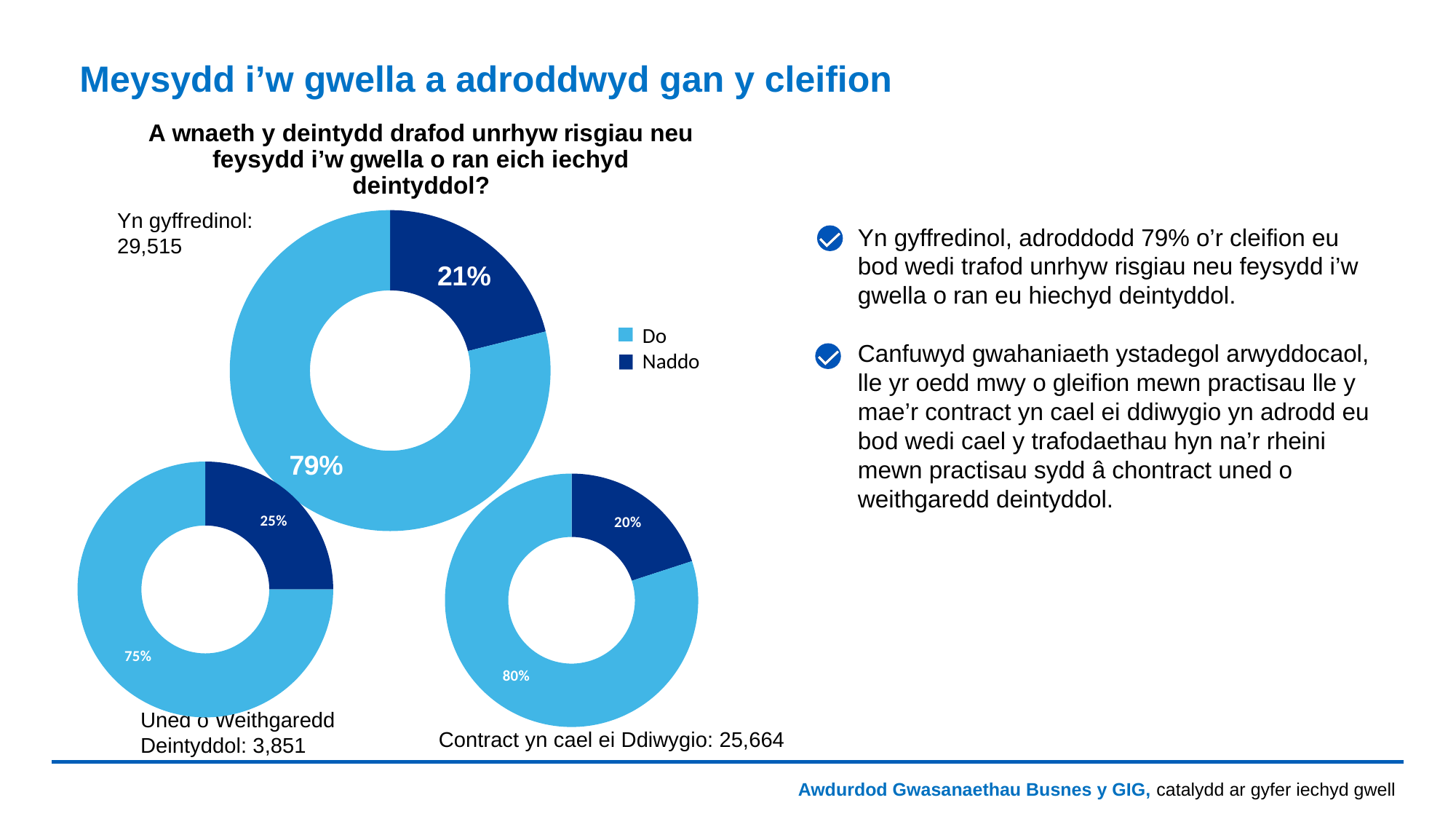
How many donut charts are shown on the slide? 3 In the bottom-left donut chart (Uned o Weithgaredd Deintyddol), what percentage is shown for Naddo? 25% What is the number shown for the Contract yn cael ei Ddiwygio chart? 25,664 In the large overall donut chart (Yn gyffredinol), what percentage is shown for Do? 79% How many series does the legend list? 2 In the large overall donut chart (Yn gyffredinol), what percentage is shown for Naddo? 21% In the bottom-right donut chart (Contract yn cael ei Ddiwygio), what percentage is shown for Do? 80% Which is larger: the Naddo share in the bottom-left chart (Uned o Weithgaredd Deintyddol) or the Naddo share in the bottom-right chart (Contract yn cael ei Ddiwygio)? Uned o Weithgaredd Deintyddol What is the total number of respondents shown for the overall chart (Yn gyffredinol)? 29,515 In the large overall donut chart, which category has the larger share, Do or Naddo? Do In the large overall donut chart, what is the difference in percentage points between Do and Naddo? 58 What type of chart is used on this slide? Donut (pie) chart